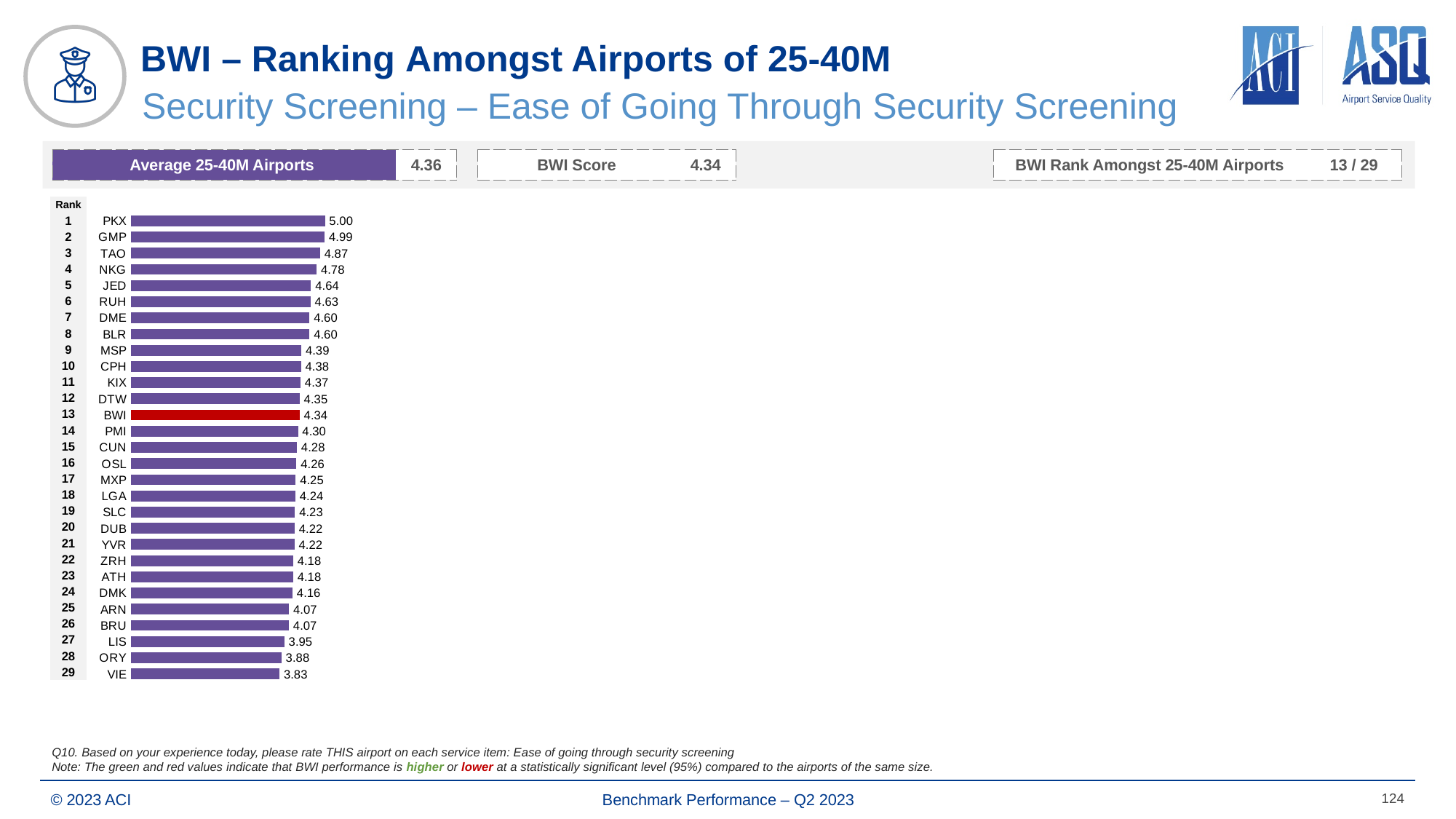
Which airport has the lowest score in the chart? VIE Which has a higher score, MSP or ORY? MSP What is the difference between the scores of BWI and LIS? 0.39 What kind of chart is shown on the slide? Bar chart How many airports are ranked in the chart? 29 What is the score for VIE? 3.83 Which airport has the highest score in the chart? PKX What is the score for BWI in the ranking chart? 4.34 What is the difference between the scores of PKX and VIE? 1.17 What is the score for PKX? 5.00 Which bar in the chart is coloured red? BWI What rank does BWI hold amongst 25-40M airports? 13 / 29